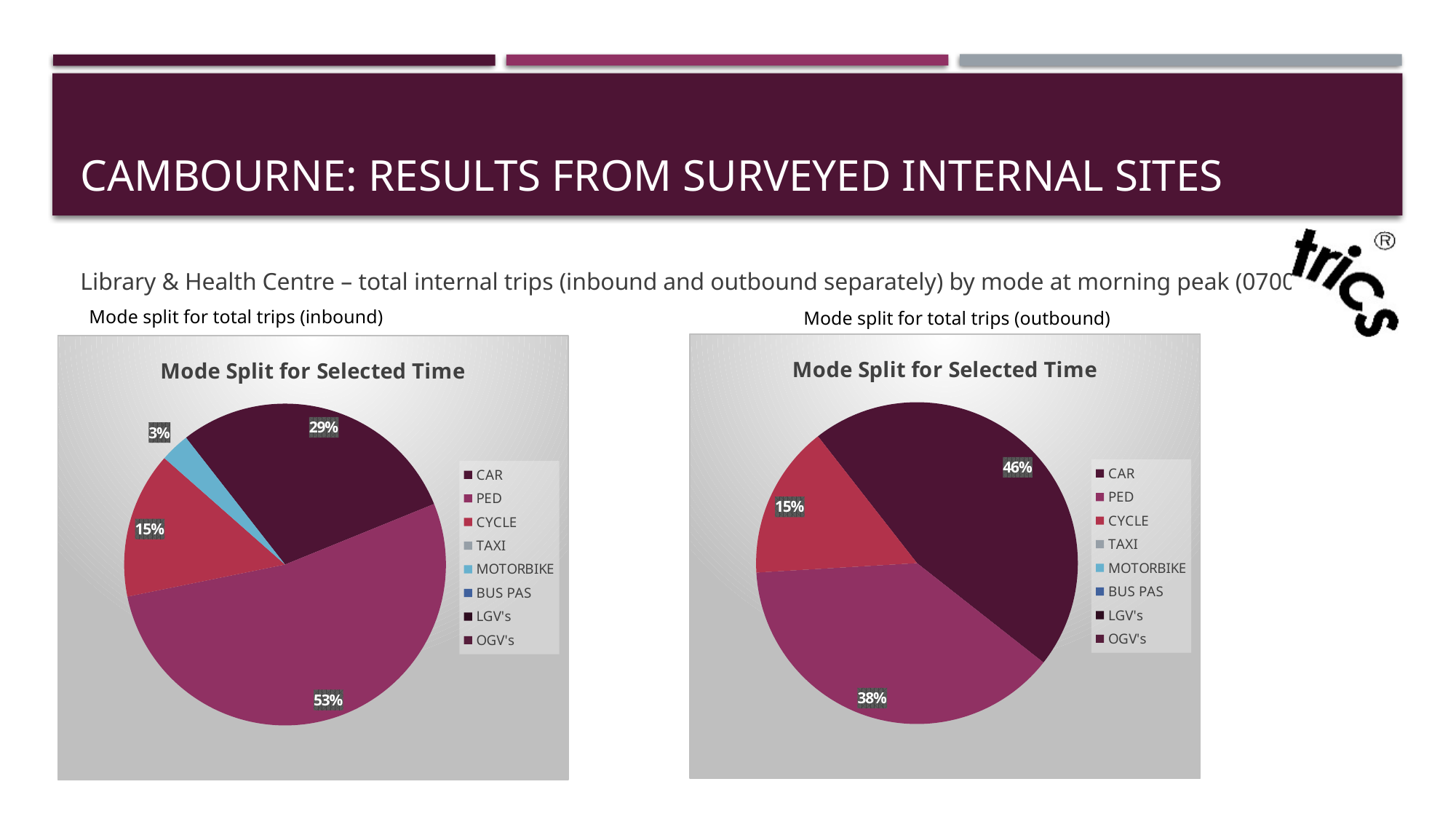
In the outbound mode split chart, what share of trips is by CAR? 46% How many entries does the legend of the outbound mode split chart list? 8 In the outbound mode split chart, what is the difference between the CAR share and the PED share? 8% In the inbound mode split chart, what share of trips is by MOTORBIKE? 3% In the inbound mode split chart, what share of trips is by PED? 53% In the inbound mode split chart, which labelled mode has the smallest share? MOTORBIKE In the outbound mode split chart, what share of trips is by PED? 38% In the inbound mode split chart, is the share for CYCLE larger or smaller than the share for CAR? smaller In the inbound mode split chart, which mode has the largest share? PED What kind of chart is the inbound mode split chart? pie chart In the inbound mode split chart, what share of trips is by CAR? 29% In the outbound mode split chart, which mode has the largest share? CAR